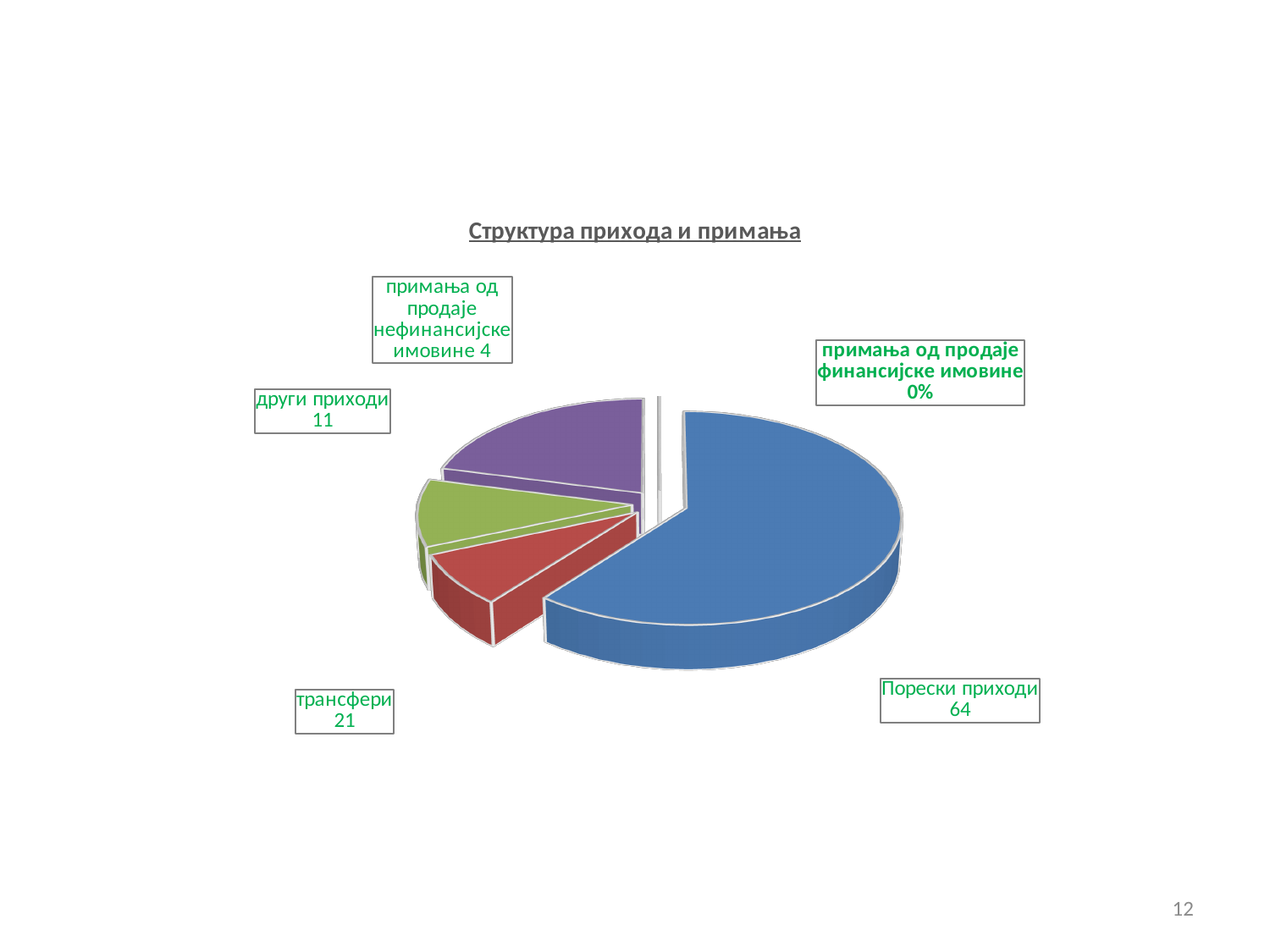
What is the title of the chart? Структура прихода и примања What kind of chart is shown on the slide? pie chart What is the value shown for примања од продаје финансијске имовине? 0% What is the value shown for примања од продаје нефинансијске имовине? 4 Which category has the smallest value in the chart? примања од продаје финансијске имовине Which category has the largest slice of the pie? Порески приходи What is the value shown for други приходи? 11 What is the value shown for трансфери? 21 What is the value shown for Порески приходи? 64 Which is larger, the value for други приходи or the value for трансфери? трансфери What is the difference between the values for Порески приходи and трансфери? 43 How many categories are labelled in the pie chart? 5